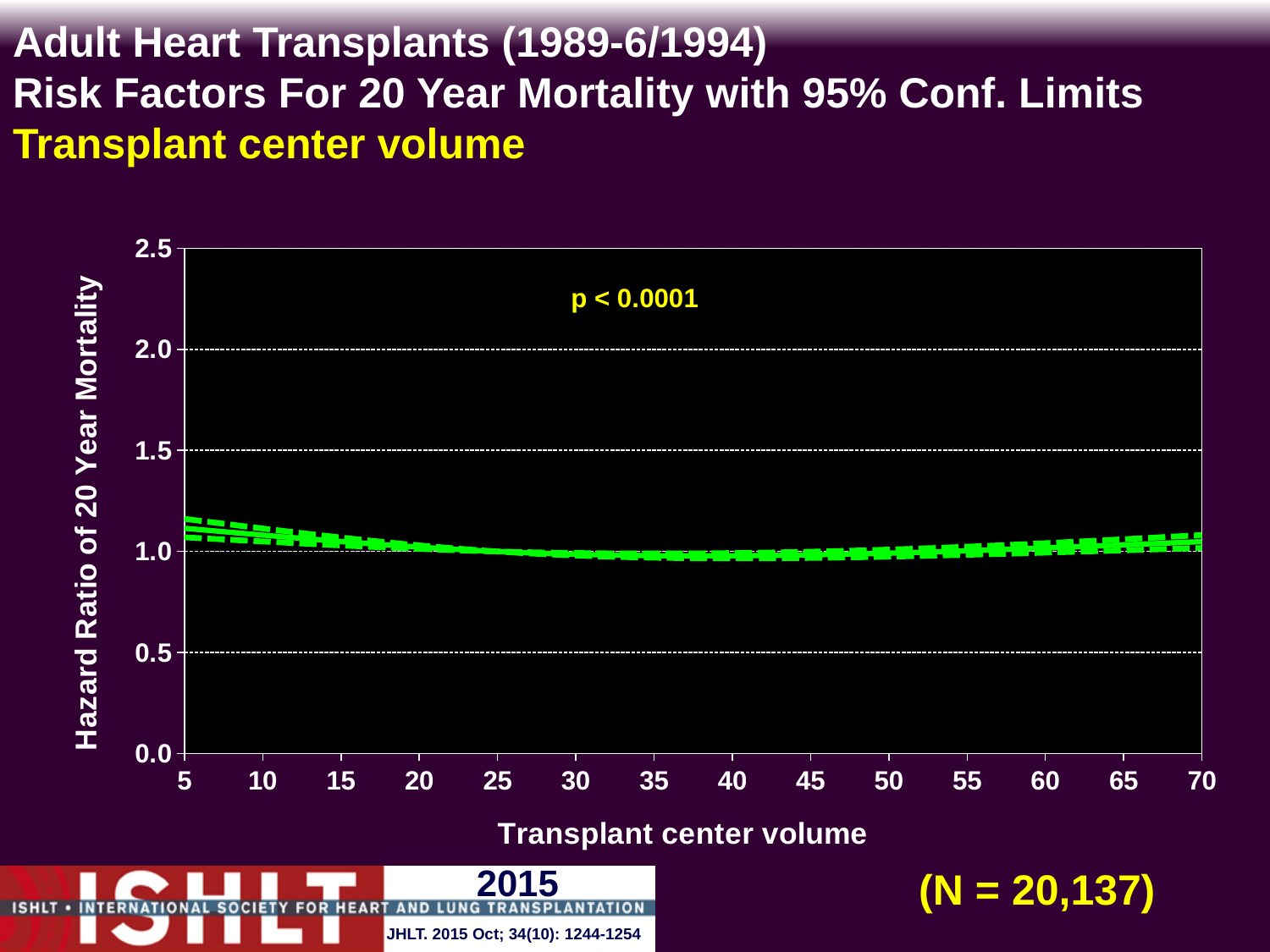
Is the hazard ratio at a transplant center volume of 5 greater or less than 1.5? less Does the hazard ratio rise or fall as transplant center volume increases from 5 to 30? fall What is the label of the y axis? Hazard Ratio of 20 Year Mortality Is the hazard ratio at a transplant center volume of 5 greater or less than 1.0? greater What kind of chart is shown on the slide? line chart What is the label of the x axis? Transplant center volume Is the hazard ratio at a transplant center volume of 70 greater or less than 2.0? less What is the highest value shown on the y axis? 2.5 How many tick labels are shown on the x axis? 14 What p-value is printed on the chart? p < 0.0001 What sample size (N) is printed on the slide? N = 20,137